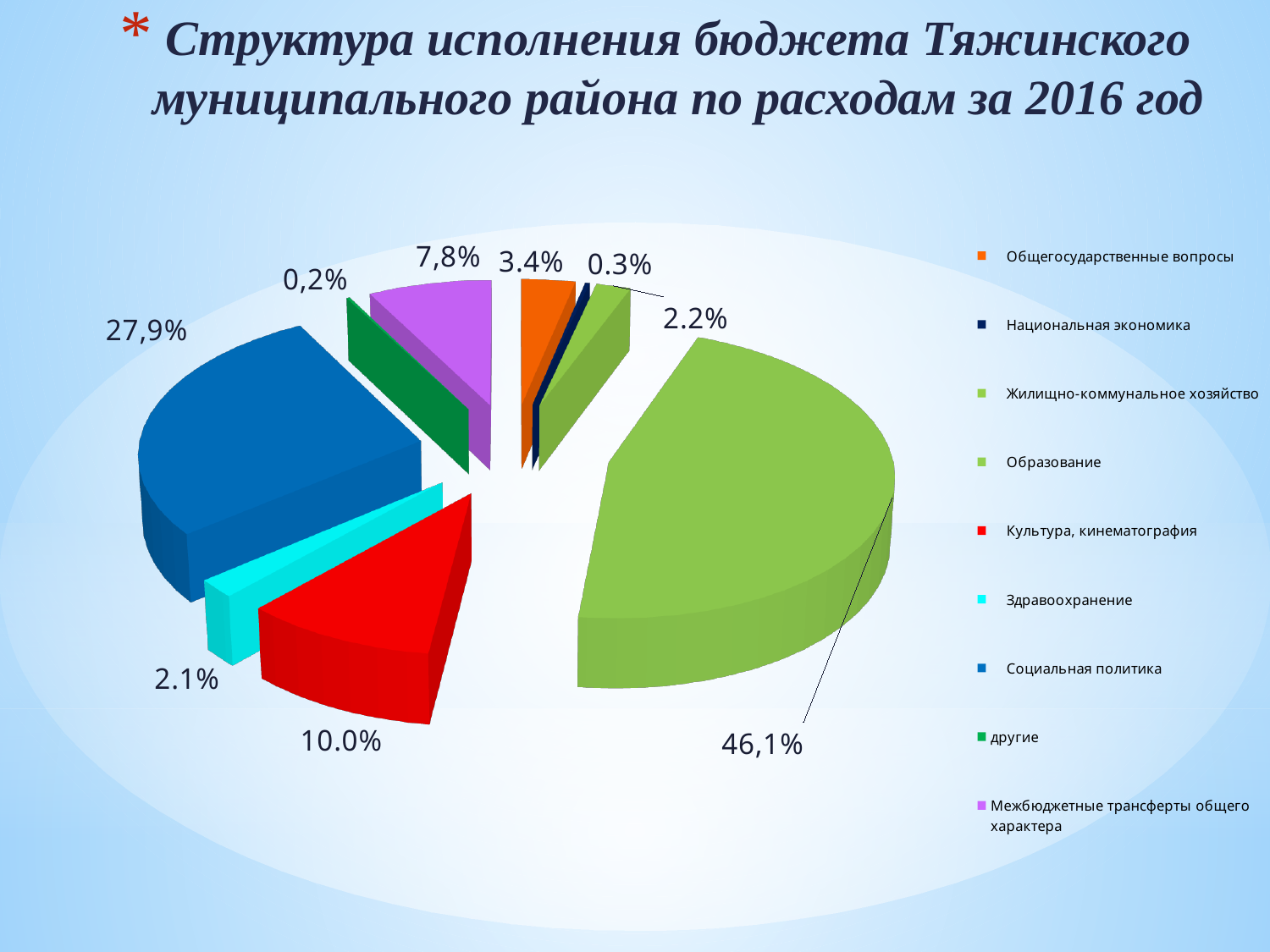
Which category has the largest slice of the pie? Образование How many categories does the legend list? 9 What share of the pie does Социальная политика have? 27,9% What is the value for Общегосударственные вопросы? 3.4% Which category has the smallest slice of the pie? другие What colour is the slice for Здравоохранение? cyan What share of the pie does Образование have? 46,1% What is the value for Здравоохранение? 2.1% What type of chart is shown on the slide? pie chart What is the value for Межбюджетные трансферты общего характера? 7,8% What is the value for Культура, кинематография? 10.0% Which is larger, Социальная политика or Культура, кинематография? Социальная политика